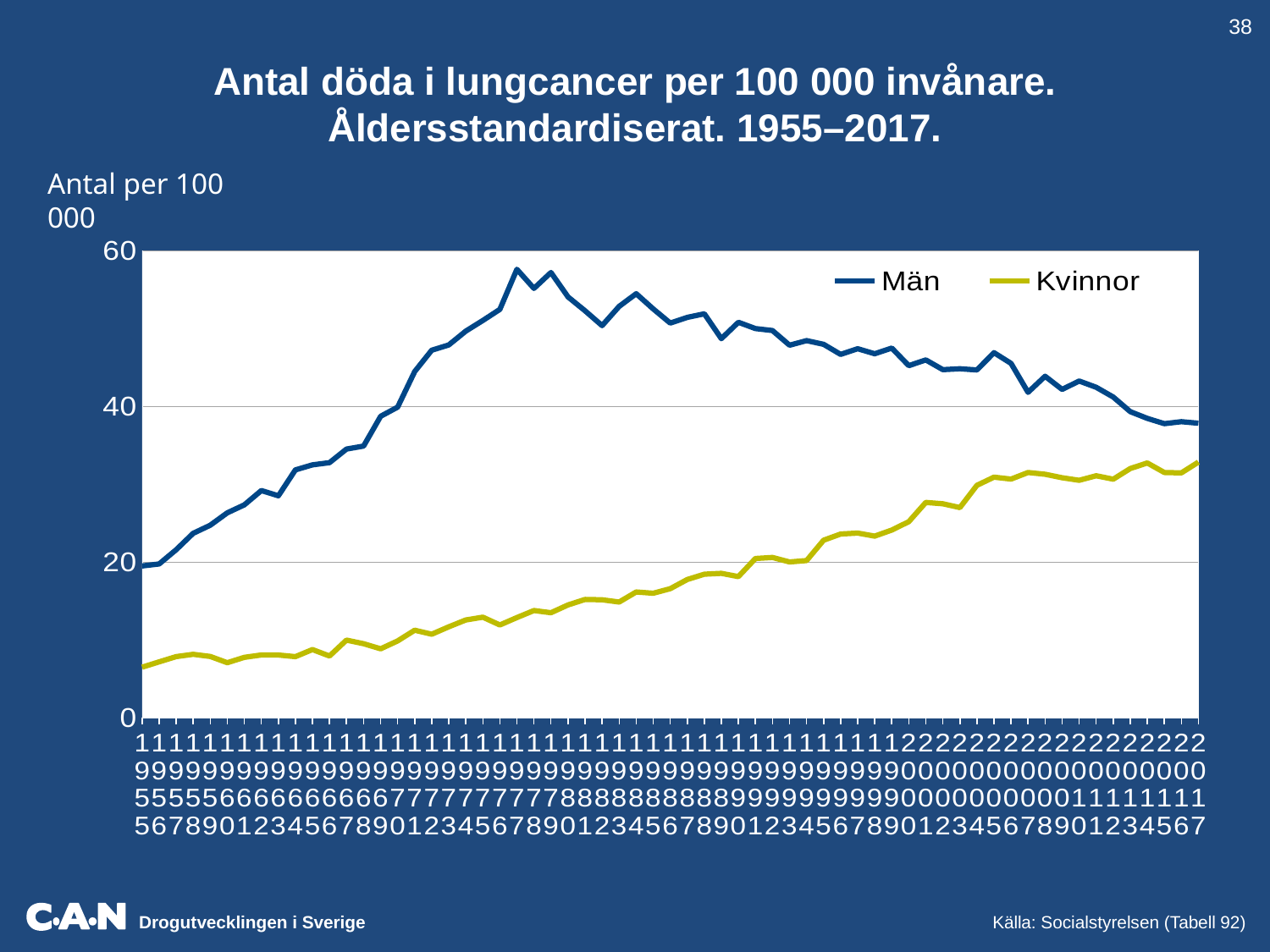
Does the Kvinnor line generally rise or fall from 1955 to 2017? rise Is the value for Män in 2017 greater or less than 20? greater Which series has the higher value in 2017, Män or Kvinnor? Män What are the two series named in the legend? Män and Kvinnor Is the value for Kvinnor in 2017 greater or less than 20? greater What kind of chart is shown on the slide? line chart Is the highest value for Kvinnor greater or less than 40? less How many years does the chart cover, from 1955 to 2017? 63 How many series does the legend list? 2 What is the label on the vertical axis? Antal per 100 000